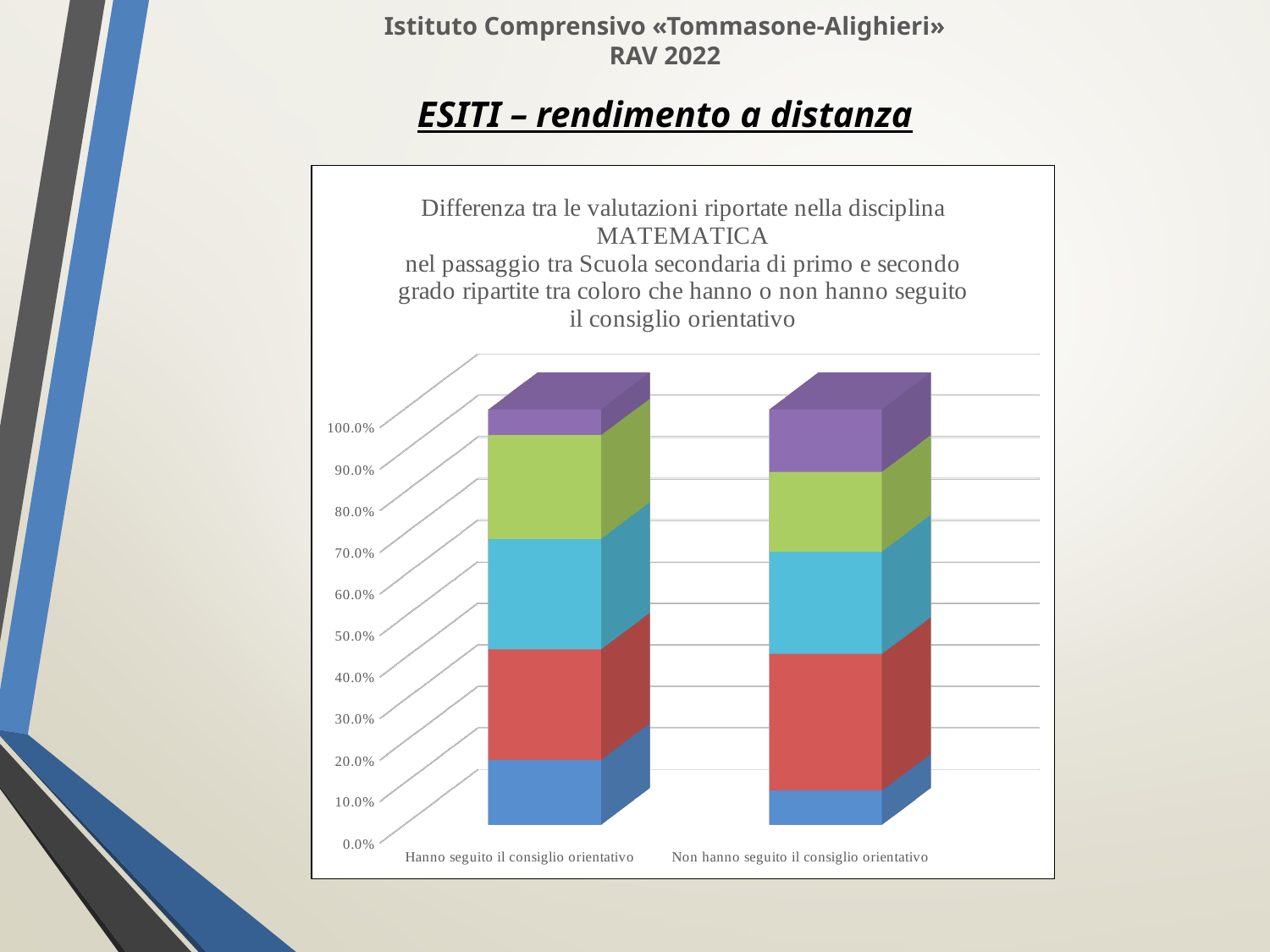
How many categories are shown on the x axis of the chart? 2 Is the top purple segment larger for 'Hanno seguito il consiglio orientativo' or for 'Non hanno seguito il consiglio orientativo'? Non hanno seguito il consiglio orientativo Which subject is named in the chart title? MATEMATICA Which coloured segment is the smallest in the bar for 'Non hanno seguito il consiglio orientativo'? Blue Which coloured segment is the smallest in the bar for 'Hanno seguito il consiglio orientativo'? Purple Is the bottom blue segment for 'Non hanno seguito il consiglio orientativo' greater or less than 20.0%? less Is the red segment larger for 'Hanno seguito il consiglio orientativo' or for 'Non hanno seguito il consiglio orientativo'? Non hanno seguito il consiglio orientativo What kind of chart is shown on the slide? Stacked bar chart How many coloured segments make up each stacked bar? 5 Which coloured segment is the largest in the bar for 'Non hanno seguito il consiglio orientativo'? Red What are the two categories on the x axis of the chart? Hanno seguito il consiglio orientativo; Non hanno seguito il consiglio orientativo Is the bottom blue segment larger for 'Hanno seguito il consiglio orientativo' or for 'Non hanno seguito il consiglio orientativo'? Hanno seguito il consiglio orientativo